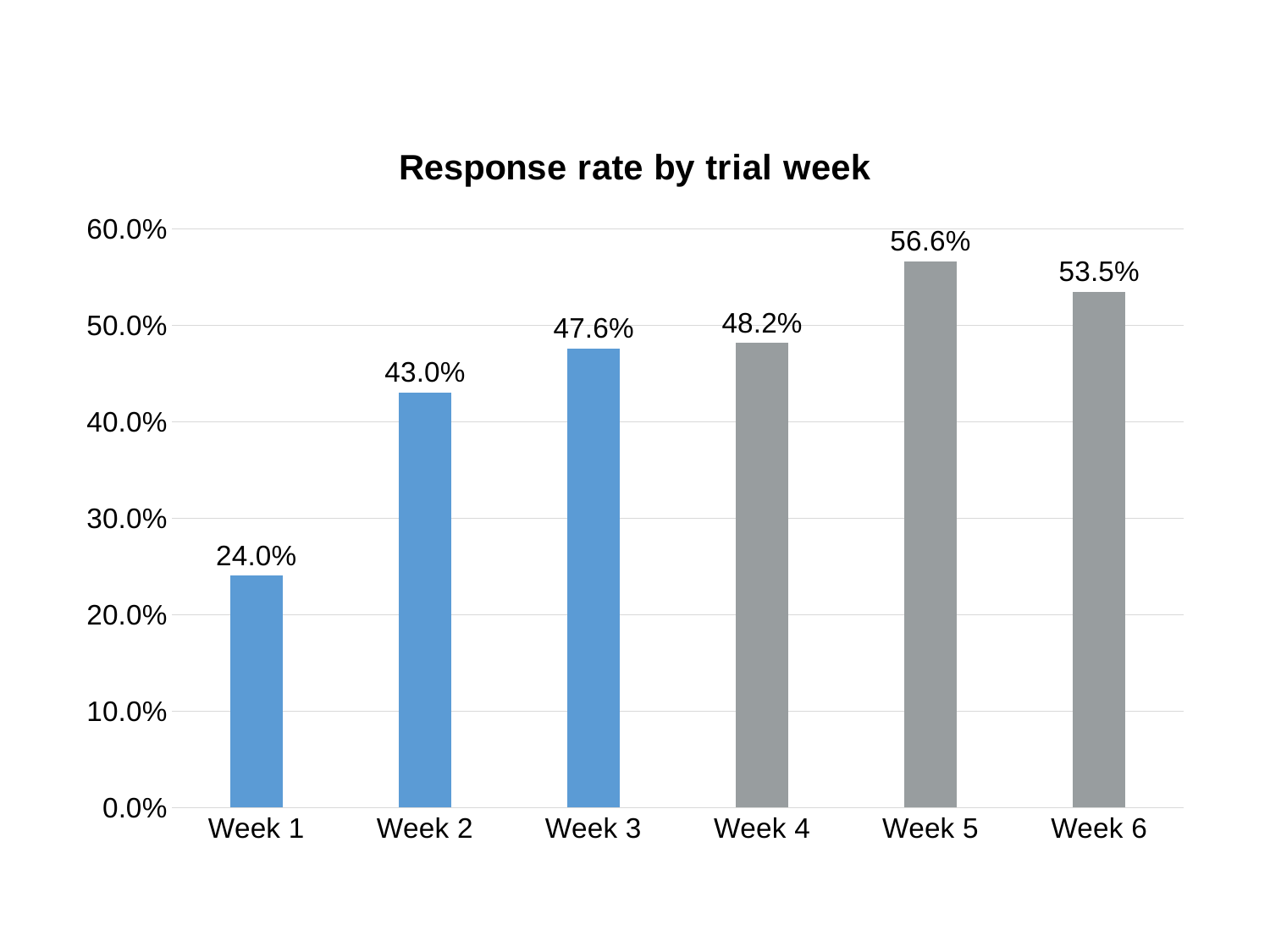
What is the difference in response rate between Week 2 and Week 1? 19.0% What kind of chart is shown on the slide? Bar chart What is the difference in response rate between Week 5 and Week 6? 3.1% What is the response rate for Week 4? 48.2% What is the response rate for Week 6? 53.5% Which week has the highest response rate? Week 5 What is the title of the chart? Response rate by trial week What is the response rate for Week 1? 24.0% Is the response rate for Week 2 greater or less than 40.0%? greater Which week has the lowest response rate? Week 1 Which has a higher response rate, Week 3 or Week 4? Week 4 How many weeks are shown on the chart? 6